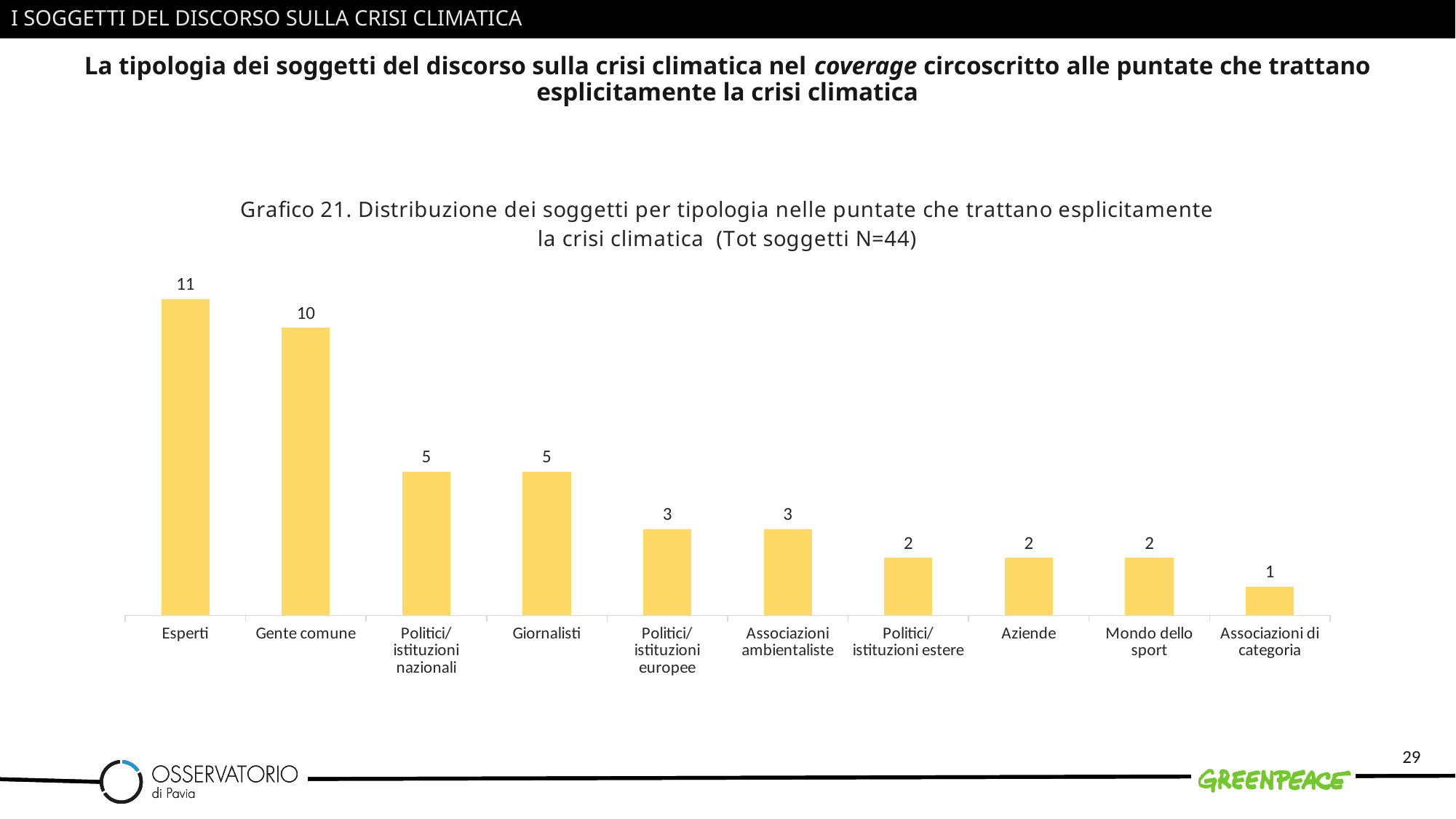
How many categories are shown in the chart? 10 Do the values rise or fall from left to right along the x axis? Fall What kind of chart is shown on the slide? Bar chart Which category has the highest value? Esperti What is the value for Gente comune? 10 Which category has the lowest value? Associazioni di categoria What is the value for Aziende? 2 What is the difference between the values for Esperti and Giornalisti? 6 What is the value for Associazioni ambientaliste? 3 What is the value for Esperti? 11 What total number of subjects (N) is stated in the chart title? 44 Which is larger, the value for Politici/istituzioni nazionali or the value for Politici/istituzioni europee? Politici/istituzioni nazionali